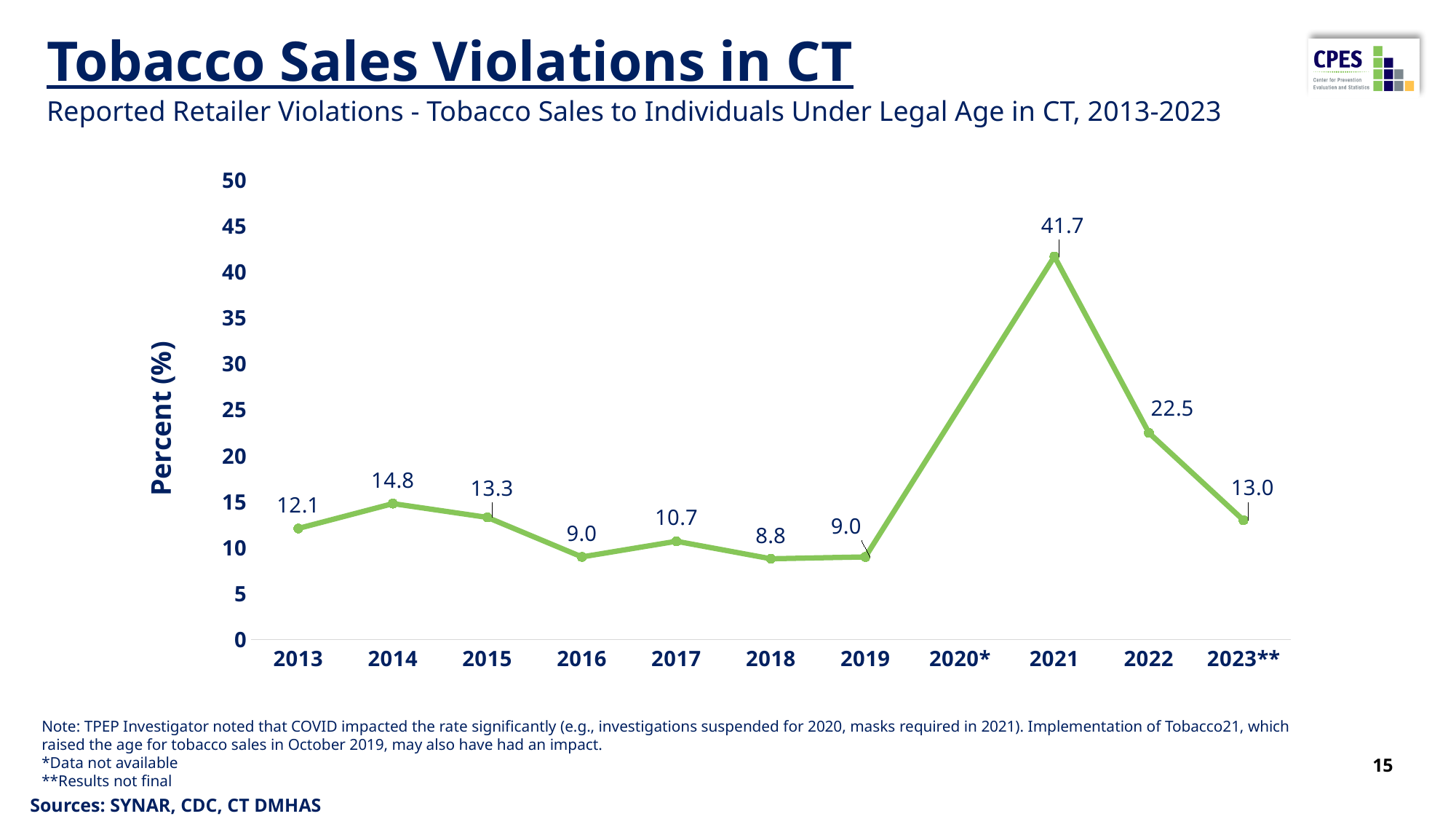
Is the value for 2022 greater or less than 20? greater What is the value shown for 2014? 14.8 Which year has a higher value, 2015 or 2017? 2015 What is the difference between the 2021 value and the 2022 value? 19.2 What is the value shown for 2023**? 13.0 Which year has the lowest violation rate? 2018 Do the values rise or fall from 2021 to 2023**? Fall Which year has the highest violation rate? 2021 What kind of chart is shown on the slide? Line chart How many data points are plotted on the line? 10 What is the reported retailer violation rate for 2021? 41.7 What is the difference between the 2014 value and the 2013 value? 2.7